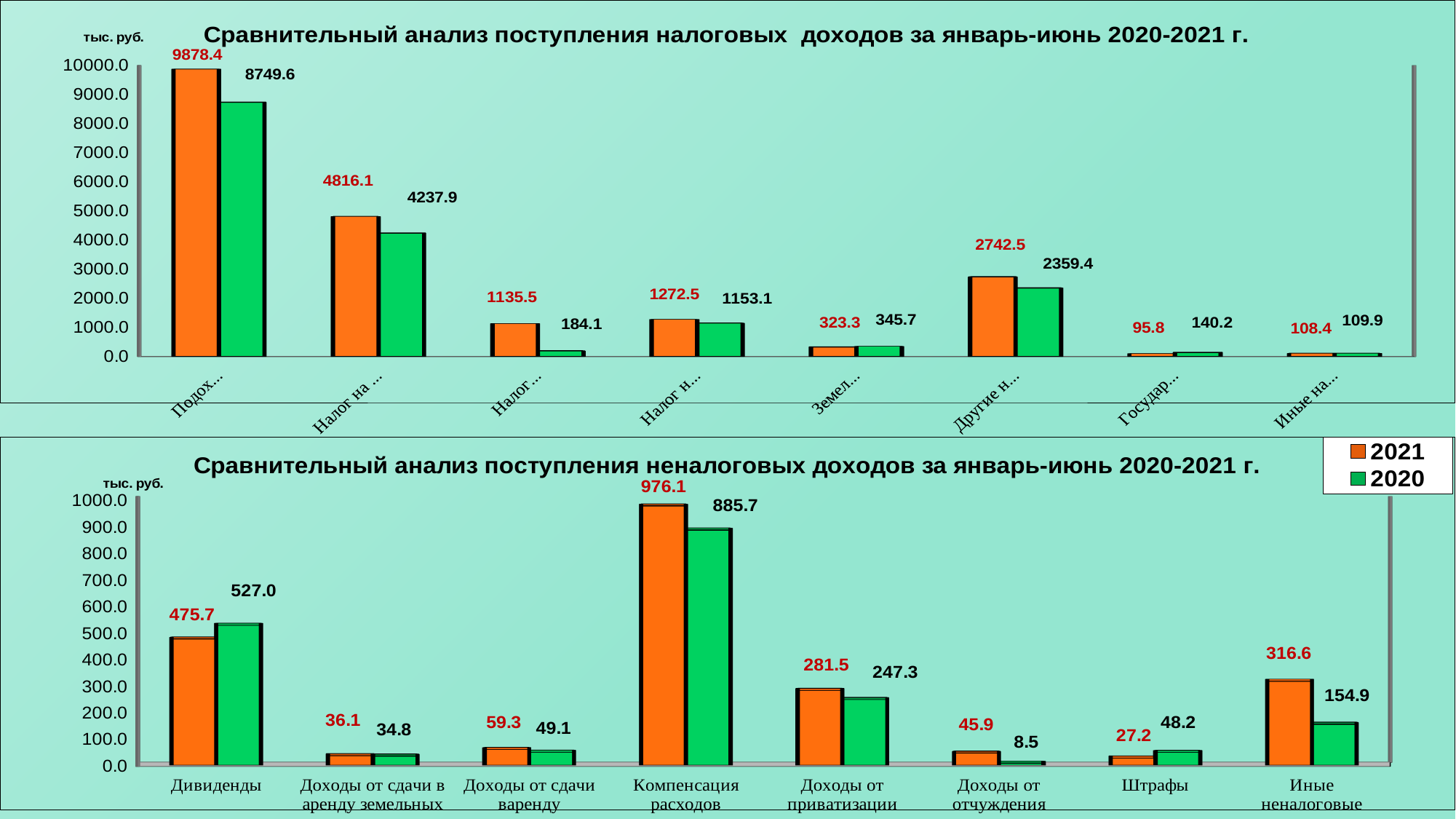
On the bottom chart (неналоговых доходов), which category has the lowest 2020 value? Доходы от отчуждения On the bottom chart (неналоговых доходов), what is the 2020 value for Доходы от отчуждения? 8.5 On the bottom chart (неналоговых доходов), which category has the highest 2021 value? Компенсация расходов On the top chart (налоговых доходов), what is the difference between the 2021 and 2020 values for the first category? 1128.8 How many series does the legend list? 2 On the bottom chart (неналоговых доходов), which is larger for Штрафы: the 2021 value or the 2020 value? 2020 What type of chart is the top chart (налоговых доходов)? Bar chart On the bottom chart (неналоговых доходов), what is the difference between the 2021 and 2020 values for Иные неналоговые? 161.7 On the bottom chart (неналоговых доходов), what is the 2021 value for Дивиденды? 475.7 On the bottom chart (неналоговых доходов), how many categories are shown on the x axis? 8 On the top chart (налоговых доходов), what is the highest 2021 value shown? 9878.4 On the bottom chart (неналоговых доходов), what is the 2020 value for Компенсация расходов? 885.7